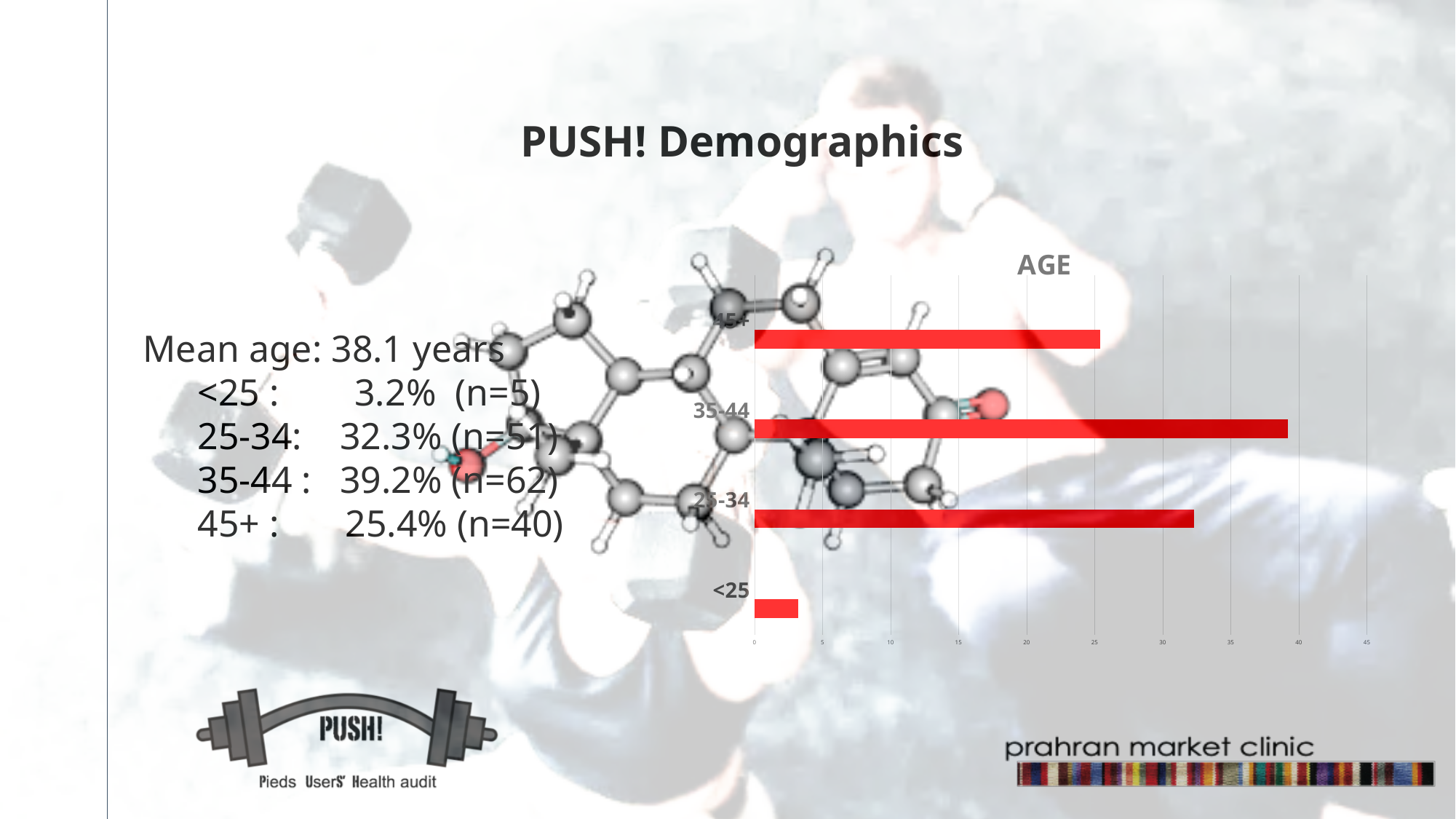
Is the value for <25 in the chart greater or less than 5? less Which bar is longer in the chart, 35-44 or 25-34? 35-44 Is the value for 25-34 in the chart greater or less than 30? greater What is the title of the chart? AGE How many age categories are plotted in the chart? 4 Which age category has the longest bar in the chart? 35-44 Which bar is longer in the chart, 25-34 or 45+? 25-34 Is the value for 45+ in the chart greater or less than 30? less What kind of chart is shown on the slide? bar chart Which age category has the shortest bar in the chart? <25 What colour are the bars in the chart? red